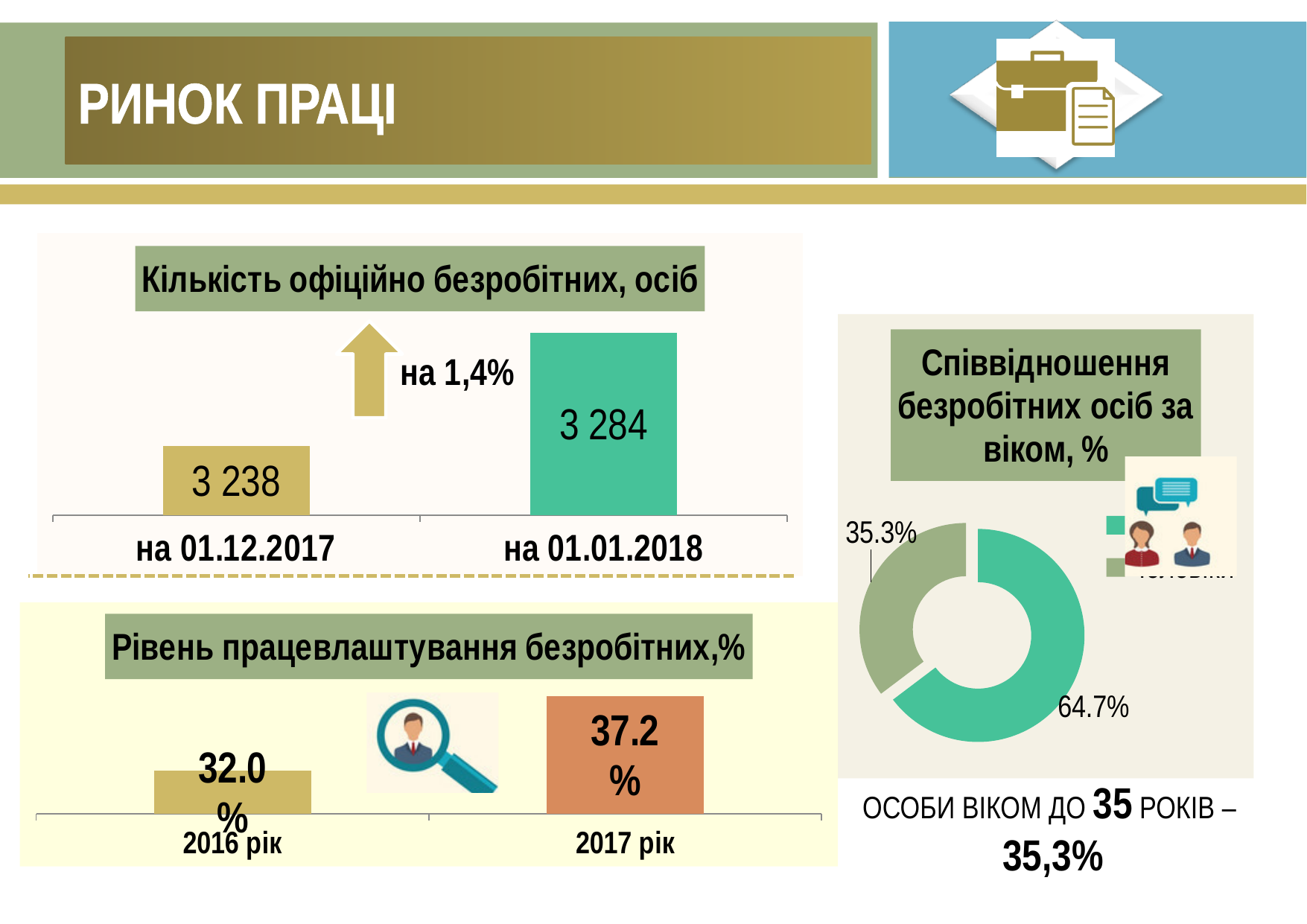
What type of chart is 'Співвідношення безробітних осіб за віком, %'? doughnut chart In the chart 'Кількість офіційно безробітних, осіб', what is the value for 'на 01.12.2017'? 3 238 In the chart 'Рівень працевлаштування безробітних,%', which year has the lower value? 2016 рік In the chart 'Рівень працевлаштування безробітних,%', what is the value for 2016 рік? 32.0% In the chart 'Співвідношення безробітних осіб за віком, %', what is the share of the larger slice? 64.7% In the chart 'Кількість офіційно безробітних, осіб', by what percentage did the number increase according to the arrow label? на 1,4% In the chart 'Кількість офіційно безробітних, осіб', what is the difference between the values for 01.01.2018 and 01.12.2017? 46 In the chart 'Кількість офіційно безробітних, осіб', what is the value for 'на 01.01.2018'? 3 284 In the chart 'Рівень працевлаштування безробітних,%', what is the value for 2017 рік? 37.2% What type of chart is 'Рівень працевлаштування безробітних,%'? bar chart In the chart 'Рівень працевлаштування безробітних,%', do the values rise or fall from 2016 to 2017? rise In the chart 'Кількість офіційно безробітних, осіб', which date has the higher value? на 01.01.2018